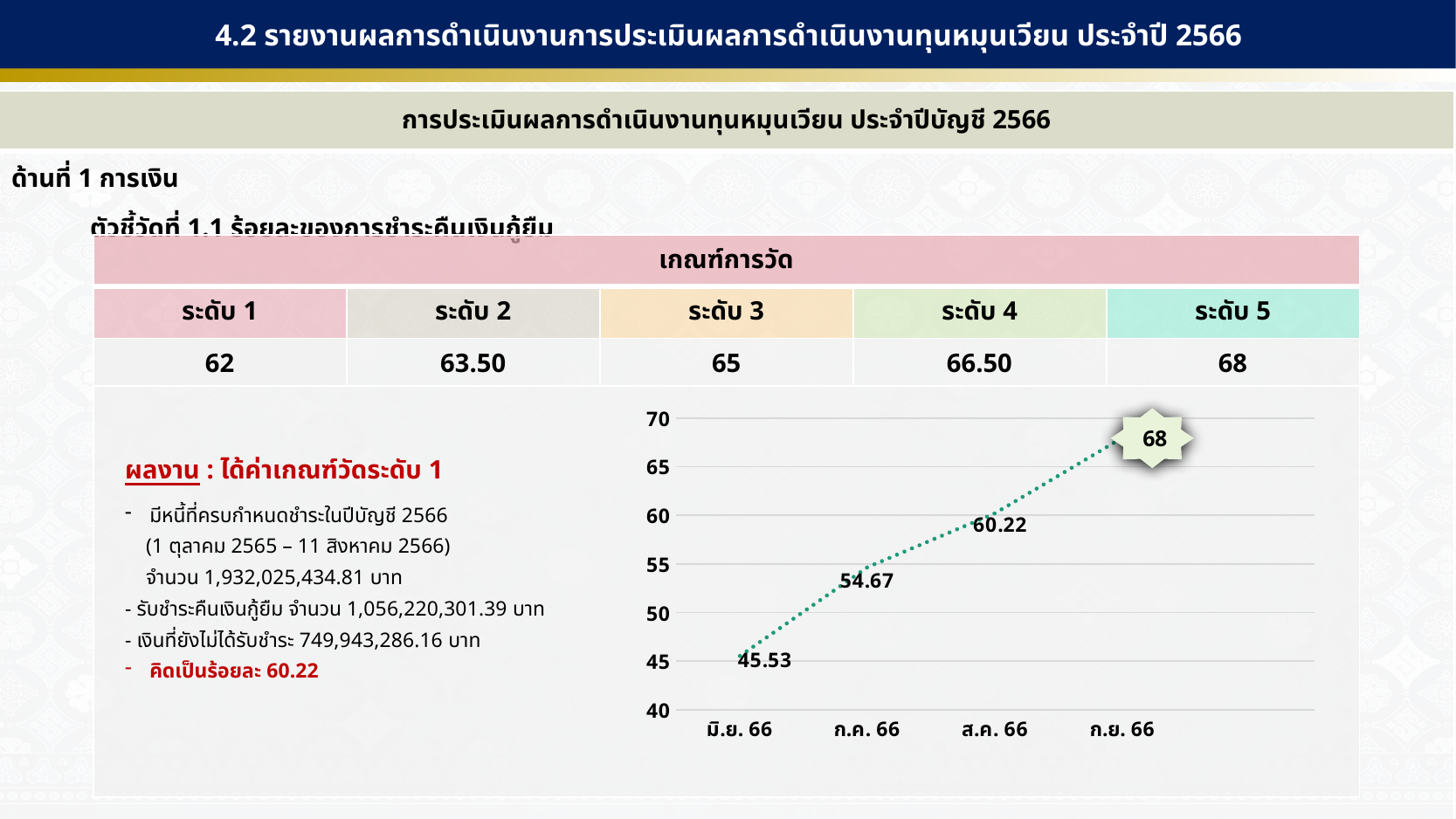
Which month has the lowest value in the chart? มิ.ย. 66 What is the difference between the values for ส.ค. 66 and ก.ค. 66? 5.55 What kind of chart is shown on the slide? line chart Which month has the highest value in the chart? ก.ย. 66 What value is shown in the callout at ก.ย. 66? 68 Is the value for ส.ค. 66 greater or less than 55? greater What is the value for มิ.ย. 66 in the chart? 45.53 Which is larger, the value for ก.ค. 66 or the value for มิ.ย. 66? ก.ค. 66 How many data points are plotted in the chart? 4 What is the value for ก.ค. 66 in the chart? 54.67 What is the value for ส.ค. 66 in the chart? 60.22 Do the values rise or fall from มิ.ย. 66 to ก.ย. 66? rise